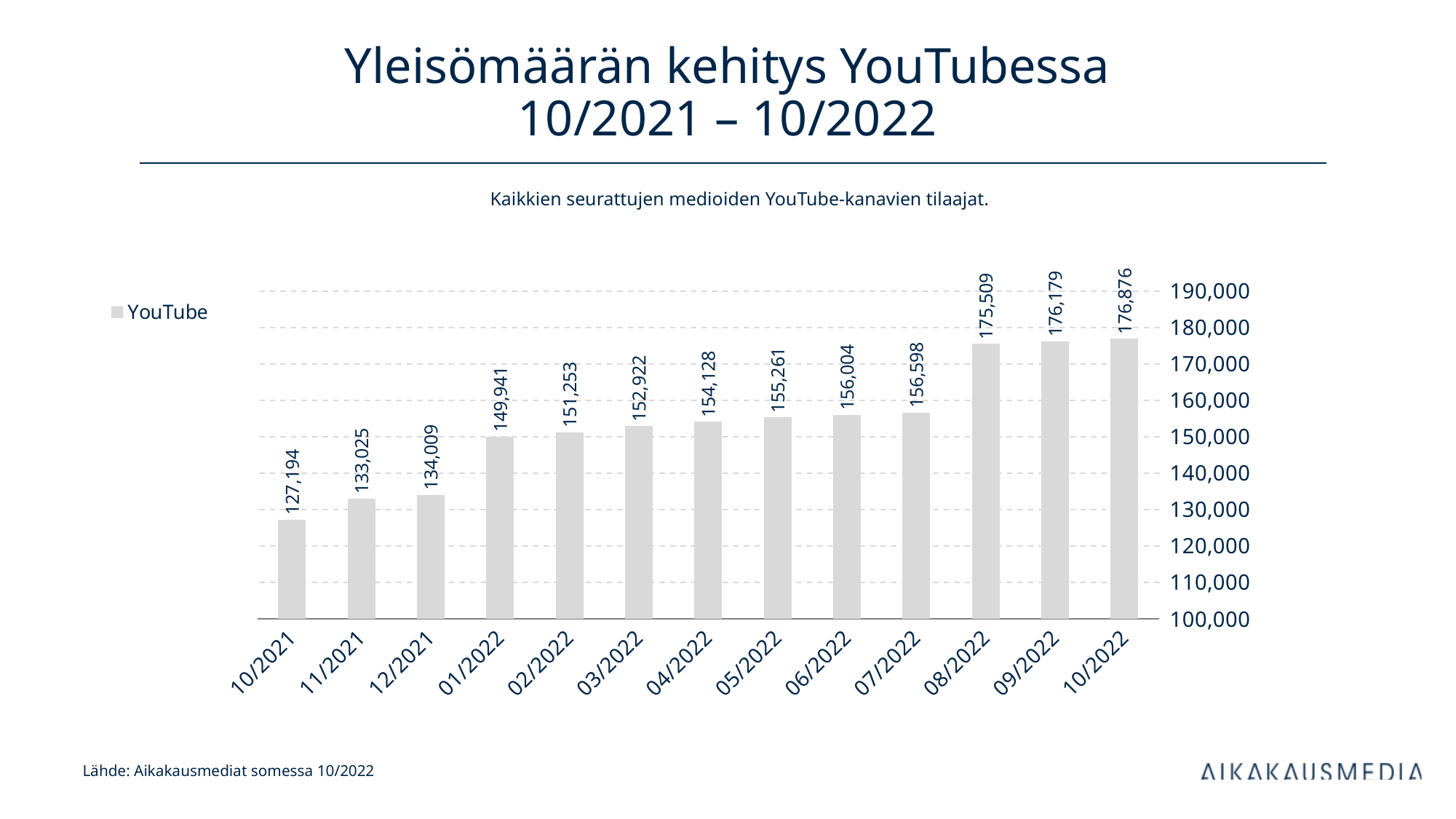
What is the value for 10/2021? 127,194 Is the value for 11/2021 greater or less than 140,000? less How many months are shown on the x axis? 13 What kind of chart is shown on the slide? bar chart Which month has the highest value? 10/2022 What is the value for 10/2022? 176,876 Which is larger, the value for 08/2022 or the value for 07/2022? 08/2022 What is the difference between the values for 10/2022 and 10/2021? 49,682 Which month has the lowest value? 10/2021 What is the difference between the values for 01/2022 and 12/2021? 15,932 Do the values rise or fall from 10/2021 to 10/2022? rise What is the value for 04/2022? 154,128